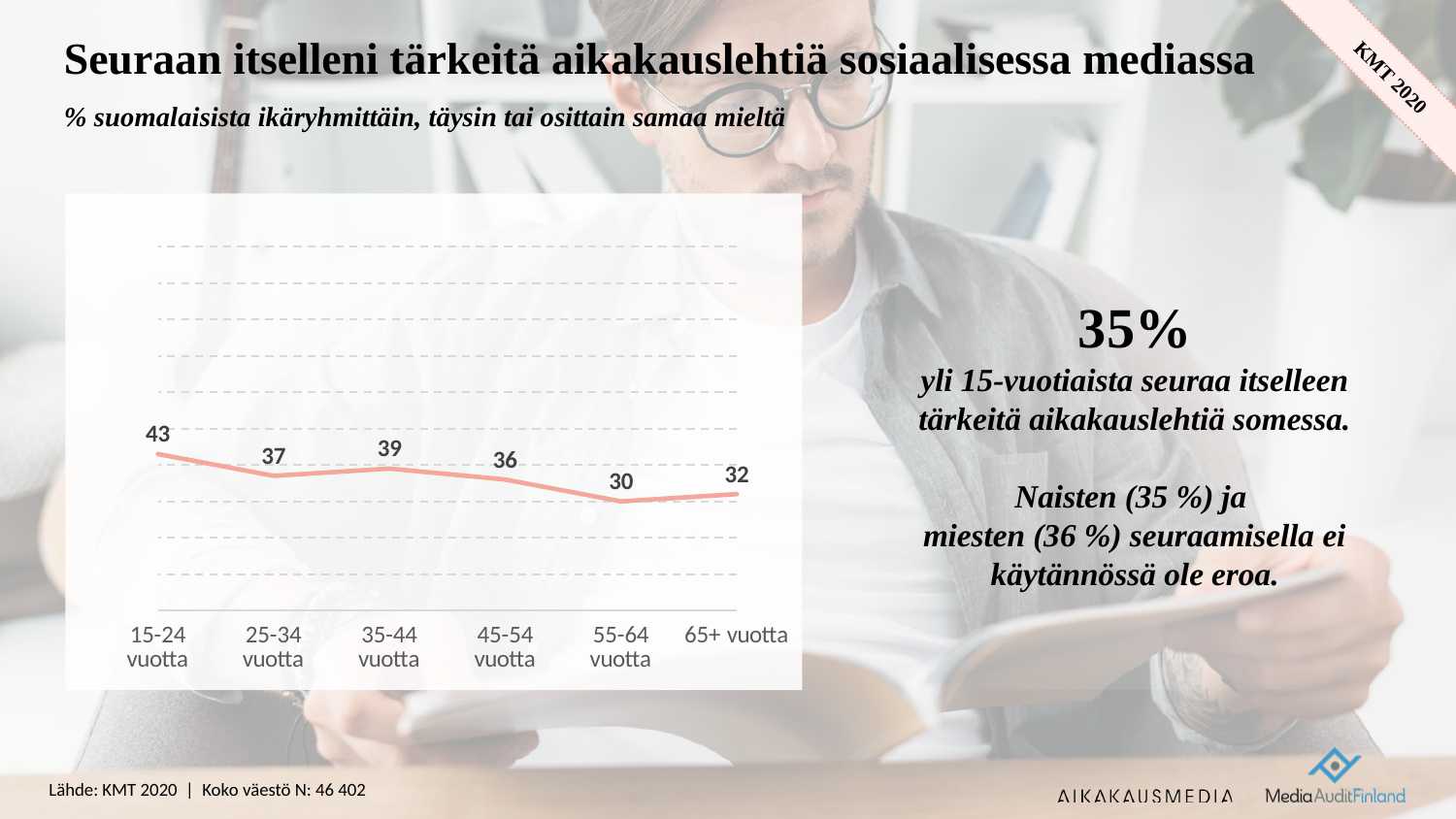
What is the value for the 15-24 vuotta age group? 43 What kind of chart is shown on the slide? Line chart How many age groups are plotted on the chart? 6 What is the difference between the values for 15-24 vuotta and 55-64 vuotta? 13 What is the value for the 55-64 vuotta age group? 30 Do the values generally rise or fall from the youngest to the oldest age group? Fall What is the title of the slide containing the chart? Seuraan itselleni tärkeitä aikakauslehtiä sosiaalisessa mediassa Which age group has the lowest value? 55-64 vuotta Which is larger, the value for 35-44 vuotta or the value for 45-54 vuotta? 35-44 vuotta What is the value for the 65+ vuotta age group? 32 What is the difference between the values for 35-44 vuotta and 25-34 vuotta? 2 Which age group has the highest value? 15-24 vuotta